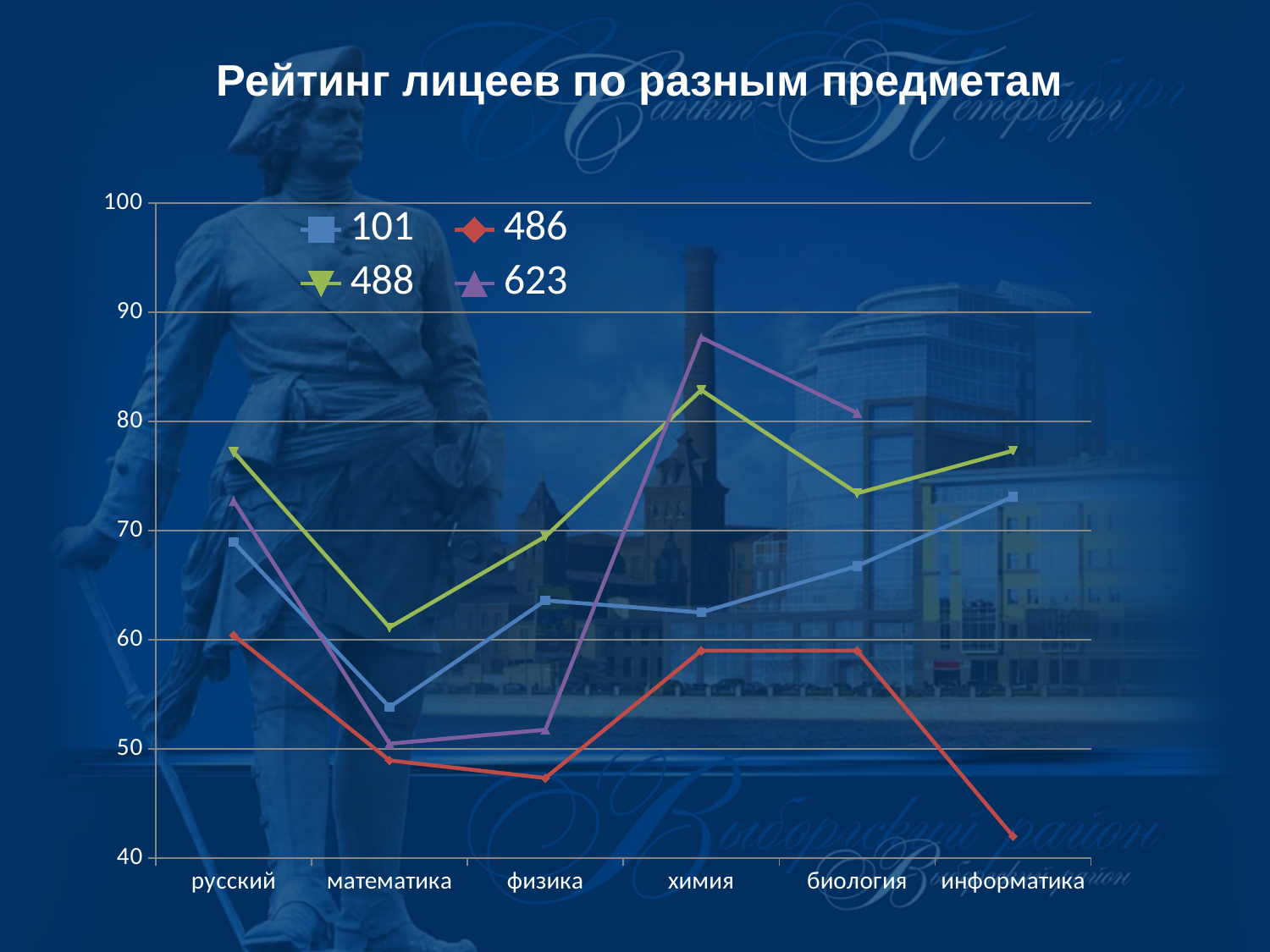
Is the value for series 623 at химия greater or less than 80? greater Which series has the highest value at химия? 623 How many subject categories are shown on the x axis? 6 For series 101, which subject has the lowest value? математика How many series does the legend list? 4 Is the value for series 486 at информатика greater or less than 50? less For series 623, which subject has the highest value? химия What is the title of the chart? Рейтинг лицеев по разным предметам At химия, which series has the larger value, 488 or 101? 488 Does the value for series 486 rise or fall from биология to информатика? fall For series 486, which subject has the lowest value? информатика What kind of chart is shown on the slide? line chart